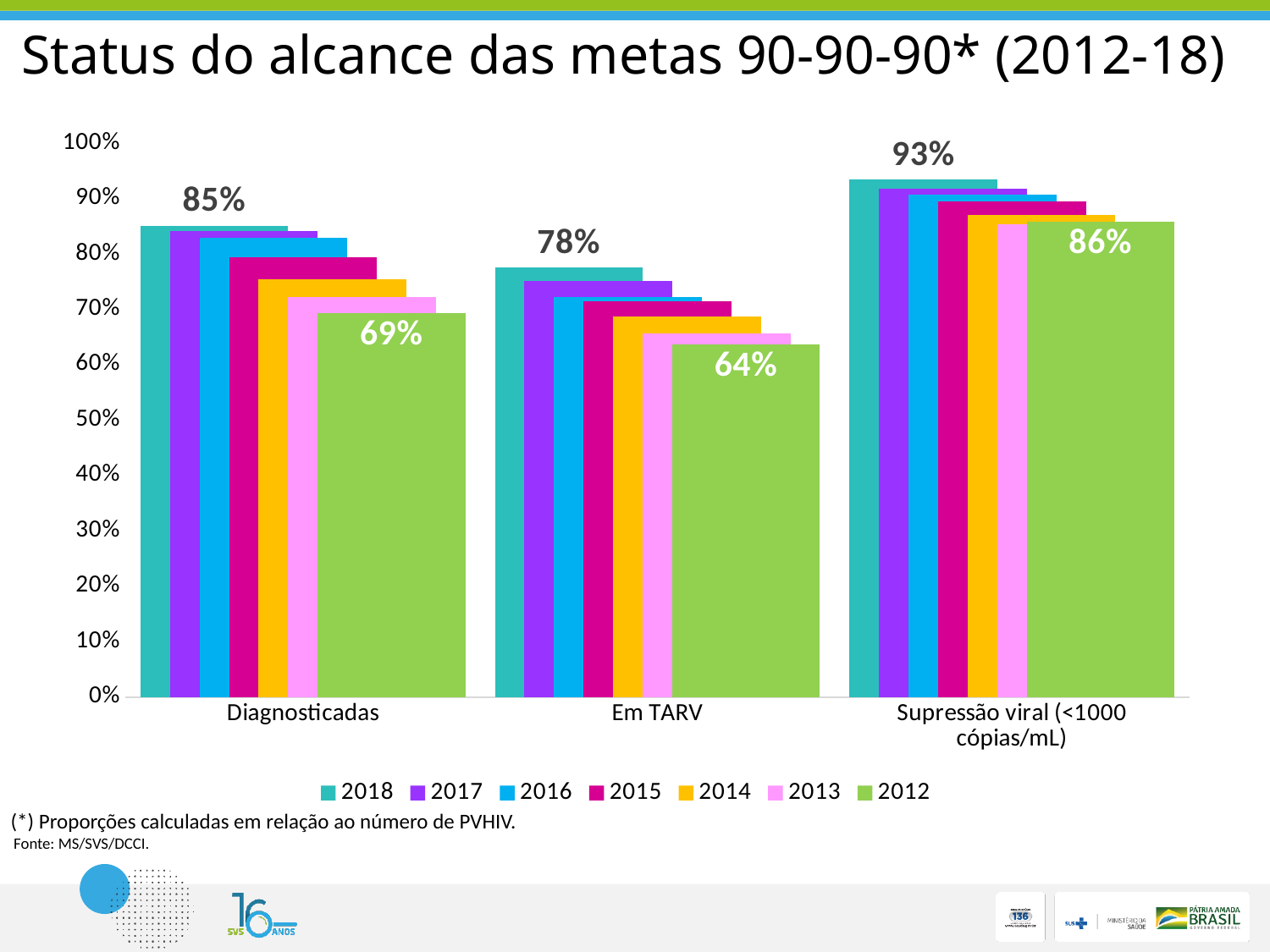
What is the value for 2018 in the Supressão viral (<1000 cópias/mL) category? 93% Which category has the highest 2018 value? Supressão viral (<1000 cópias/mL) What is the value for 2018 in the Diagnosticadas category? 85% What kind of chart is shown on the slide? bar chart What is the value for 2012 in the Supressão viral (<1000 cópias/mL) category? 86% Which category has the lowest 2012 value? Em TARV How many series does the legend list? 7 How many categories are shown on the x axis? 3 What is the difference between the 2018 and 2012 values in the Em TARV category? 14% What is the value for 2012 in the Em TARV category? 64% Is the value for 2015 in the Em TARV category greater or less than 60%? greater What is the difference between the 2018 and 2012 values in the Diagnosticadas category? 16%